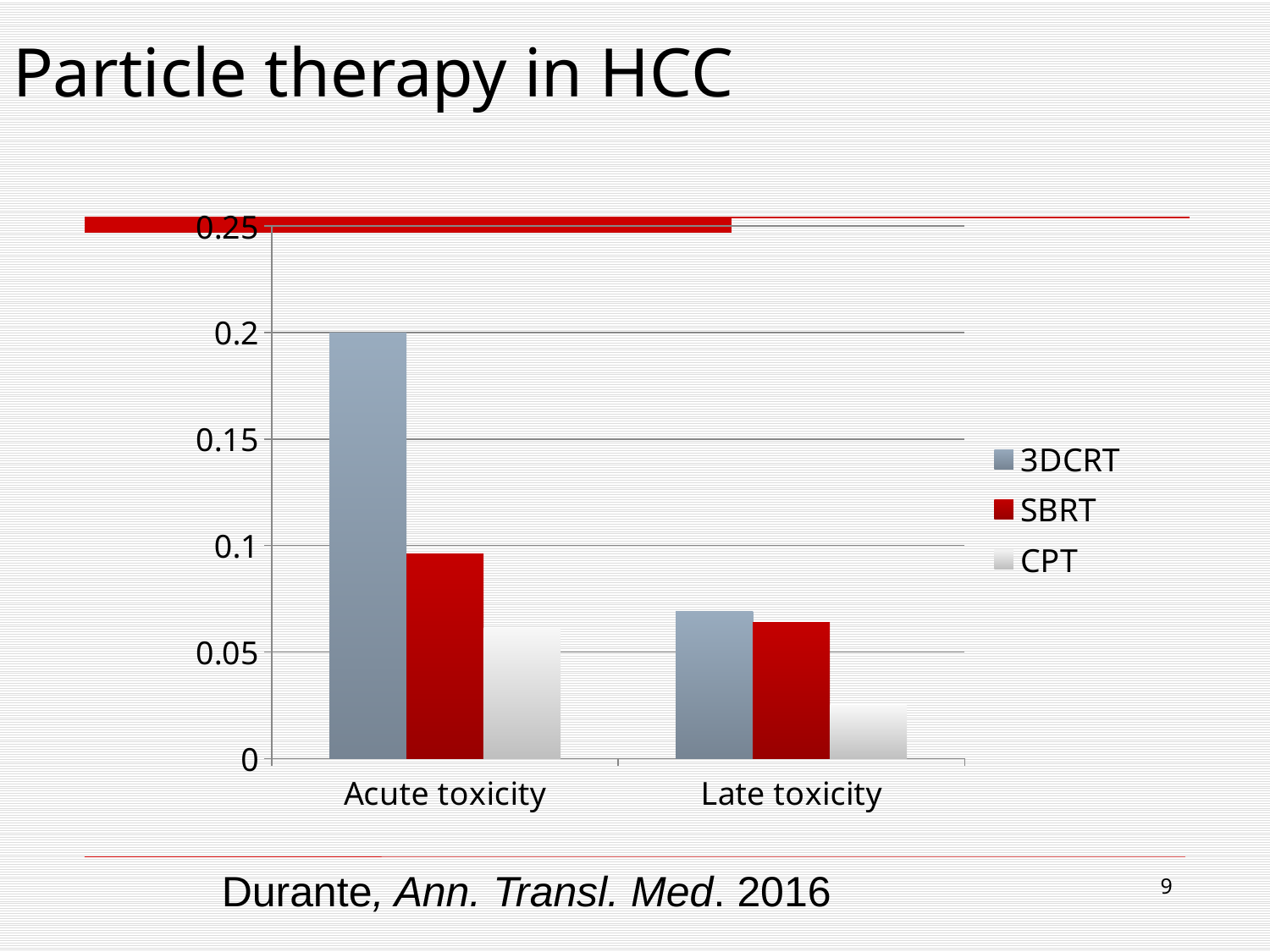
Is the value for 3DCRT in Late toxicity greater or less than 0.05? greater Which series has the lowest value for Late toxicity? CPT Which series has the highest value for Acute toxicity? 3DCRT Is the value for CPT in Late toxicity greater or less than 0.05? less Do the values for 3DCRT rise or fall from Acute toxicity to Late toxicity? fall Which is larger for Late toxicity, SBRT or CPT? SBRT How many categories are shown on the x axis? 2 Is the value for 3DCRT in Acute toxicity greater or less than 0.15? greater What kind of chart is shown on the slide? bar chart Which is larger for Acute toxicity, 3DCRT or SBRT? 3DCRT How many series does the legend list? 3